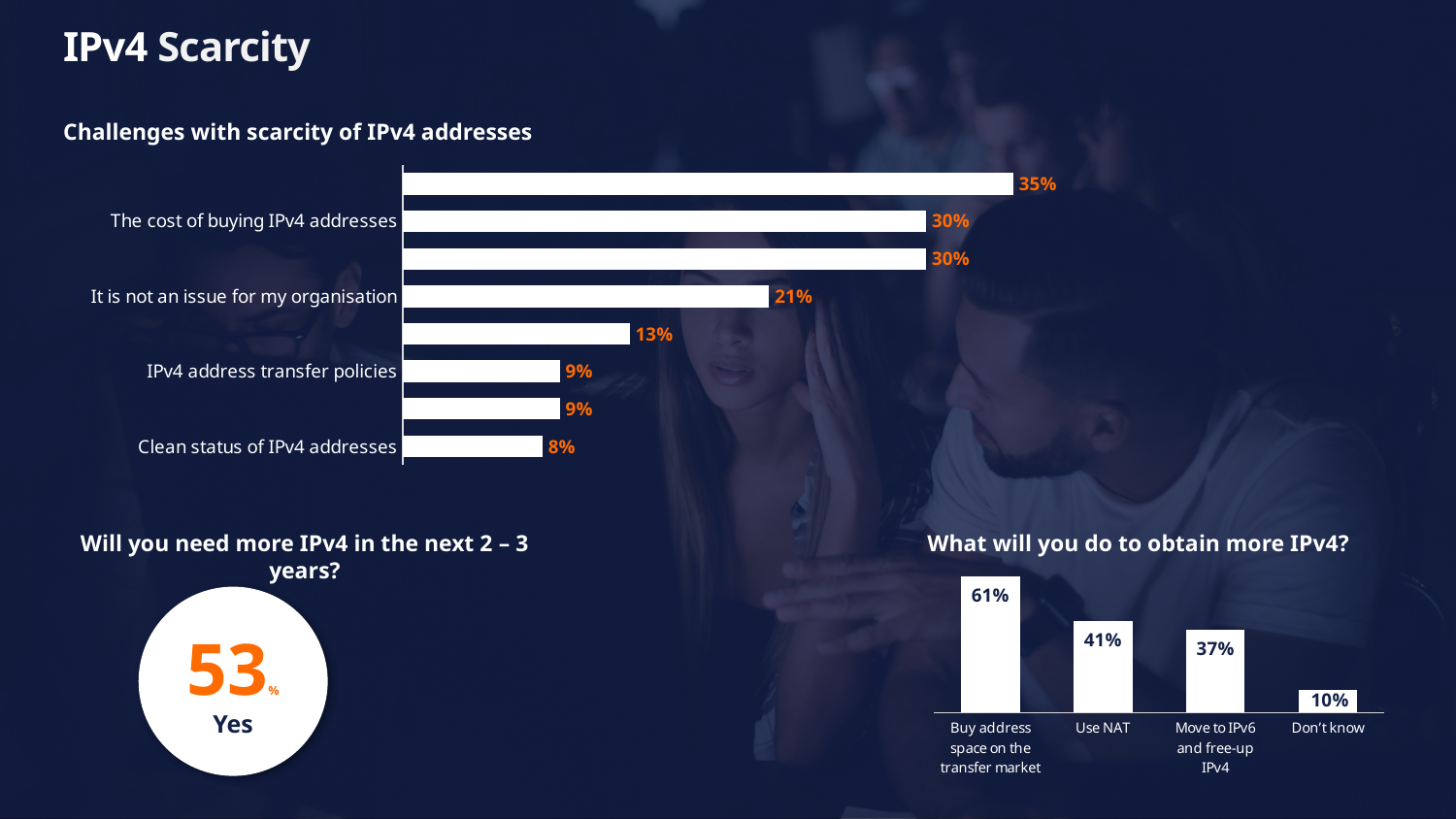
What kind of chart is the 'Challenges with scarcity of IPv4 addresses' chart? Bar chart In the 'What will you do to obtain more IPv4?' chart, which category has the lowest value? Don't know How many bars are plotted in the 'Challenges with scarcity of IPv4 addresses' chart? 8 How many categories are shown in the 'What will you do to obtain more IPv4?' chart? 4 What is the highest value shown in the 'Challenges with scarcity of IPv4 addresses' chart? 35% In the 'Challenges with scarcity of IPv4 addresses' chart, what is the value for 'Clean status of IPv4 addresses'? 8% In the 'What will you do to obtain more IPv4?' chart, what is the difference between 'Use NAT' and 'Move to IPv6 and free-up IPv4'? 4 percentage points In the 'Challenges with scarcity of IPv4 addresses' chart, what is the value for 'IPv4 address transfer policies'? 9% In the 'What will you do to obtain more IPv4?' chart, what is the value for 'Buy address space on the transfer market'? 61% In the 'Challenges with scarcity of IPv4 addresses' chart, what is the value for 'It is not an issue for my organisation'? 21% In the 'Challenges with scarcity of IPv4 addresses' chart, what is the value for 'The cost of buying IPv4 addresses'? 30% In the 'Challenges with scarcity of IPv4 addresses' chart, what is the difference between 'The cost of buying IPv4 addresses' and 'Clean status of IPv4 addresses'? 22 percentage points